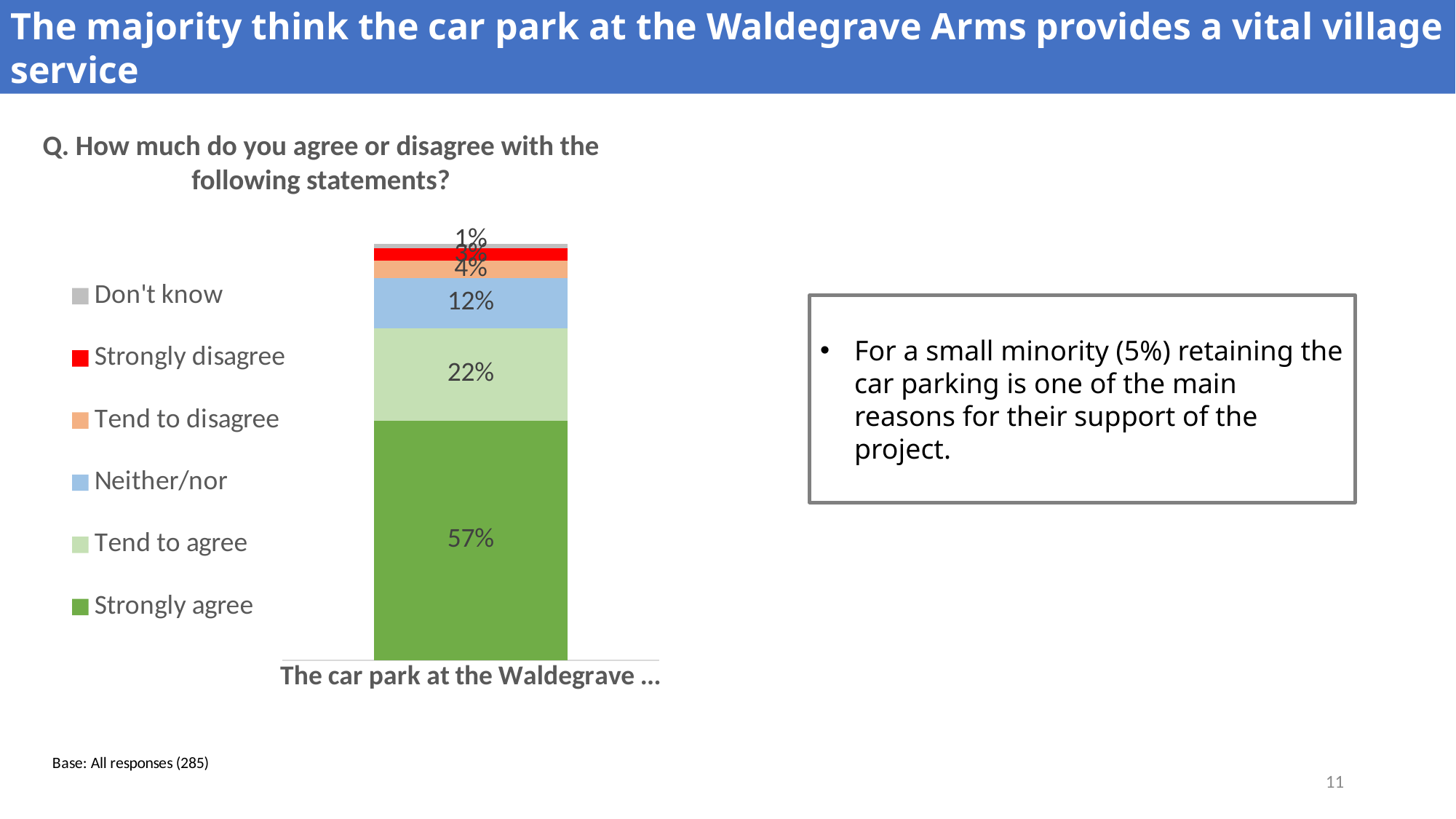
What is the value shown for 'Tend to agree' in the stacked bar? 22% Which response option has the largest share of the stacked bar? Strongly agree What percentage of respondents strongly agree that the car park at the Waldegrave Arms provides a vital village service? 57% What is the value shown for 'Tend to disagree'? 4% Which is larger, the share for 'Neither/nor' or the share for 'Tend to disagree'? Neither/nor What kind of chart is shown on the slide? Stacked bar chart What percentage of respondents answered 'Neither/nor'? 12% How many series does the legend list? 6 How many percentage points higher is 'Strongly agree' than 'Tend to agree'? 35 percentage points What percentage of respondents answered 'Don't know'? 1% Which response option has the smallest share of the stacked bar? Don't know What colour represents 'Strongly disagree' in the legend? Red